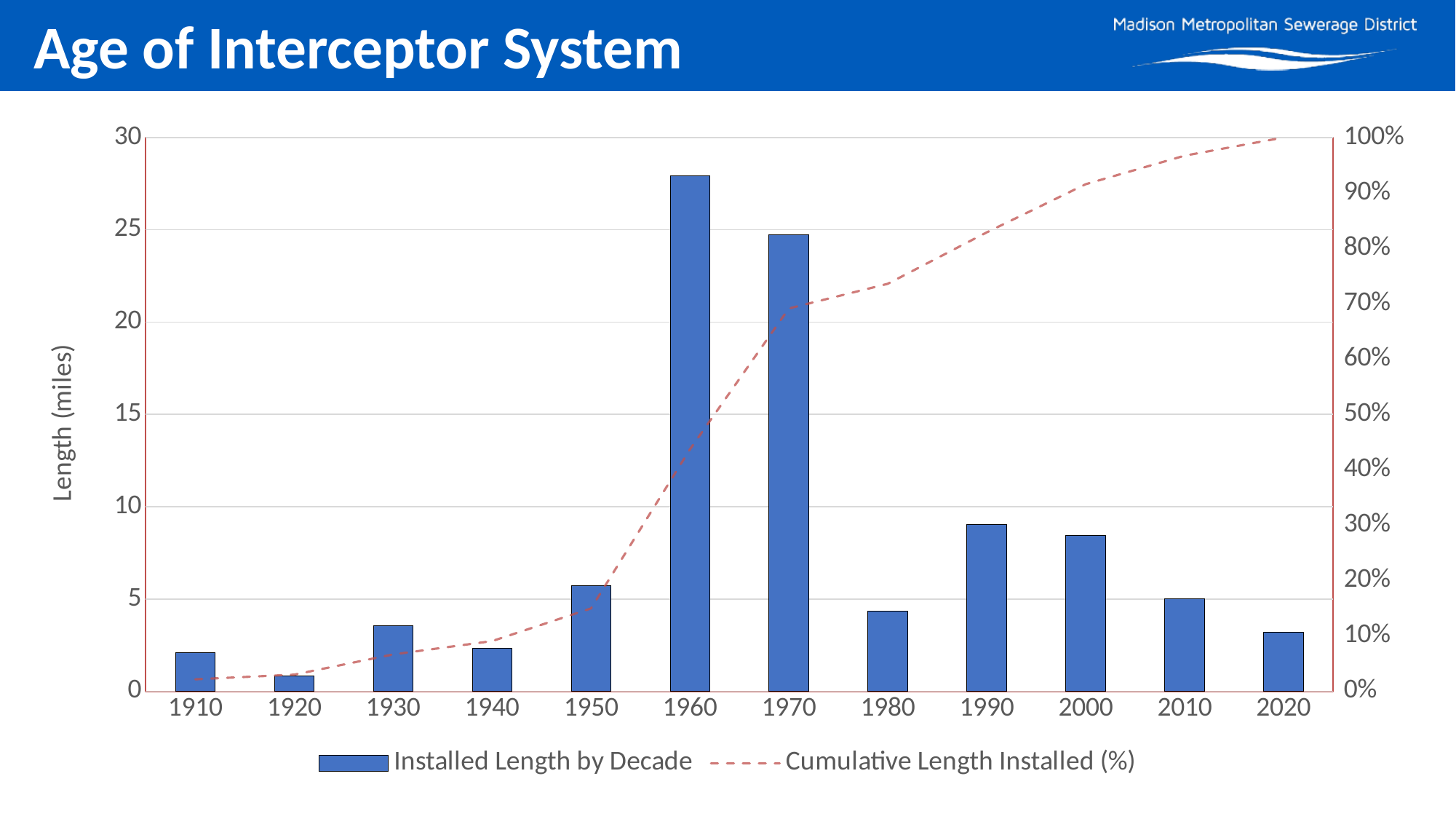
Which decade has a larger Installed Length by Decade, 1930 or 1940? 1930 Is the Installed Length by Decade for 1980 greater or less than 5? less Is the Installed Length by Decade for 1990 greater or less than 10? less What kind of chart is used to show Installed Length by Decade? bar chart Is the Cumulative Length Installed (%) for 1970 greater or less than 60%? greater Does the Cumulative Length Installed (%) line rise or fall from 1910 to 2020? rise How many decades are shown on the x axis? 12 How many series does the legend list? 2 Which decade has the highest Installed Length by Decade? 1960 Which decade has the lowest Installed Length by Decade? 1920 Which decade has a larger Installed Length by Decade, 1960 or 1970? 1960